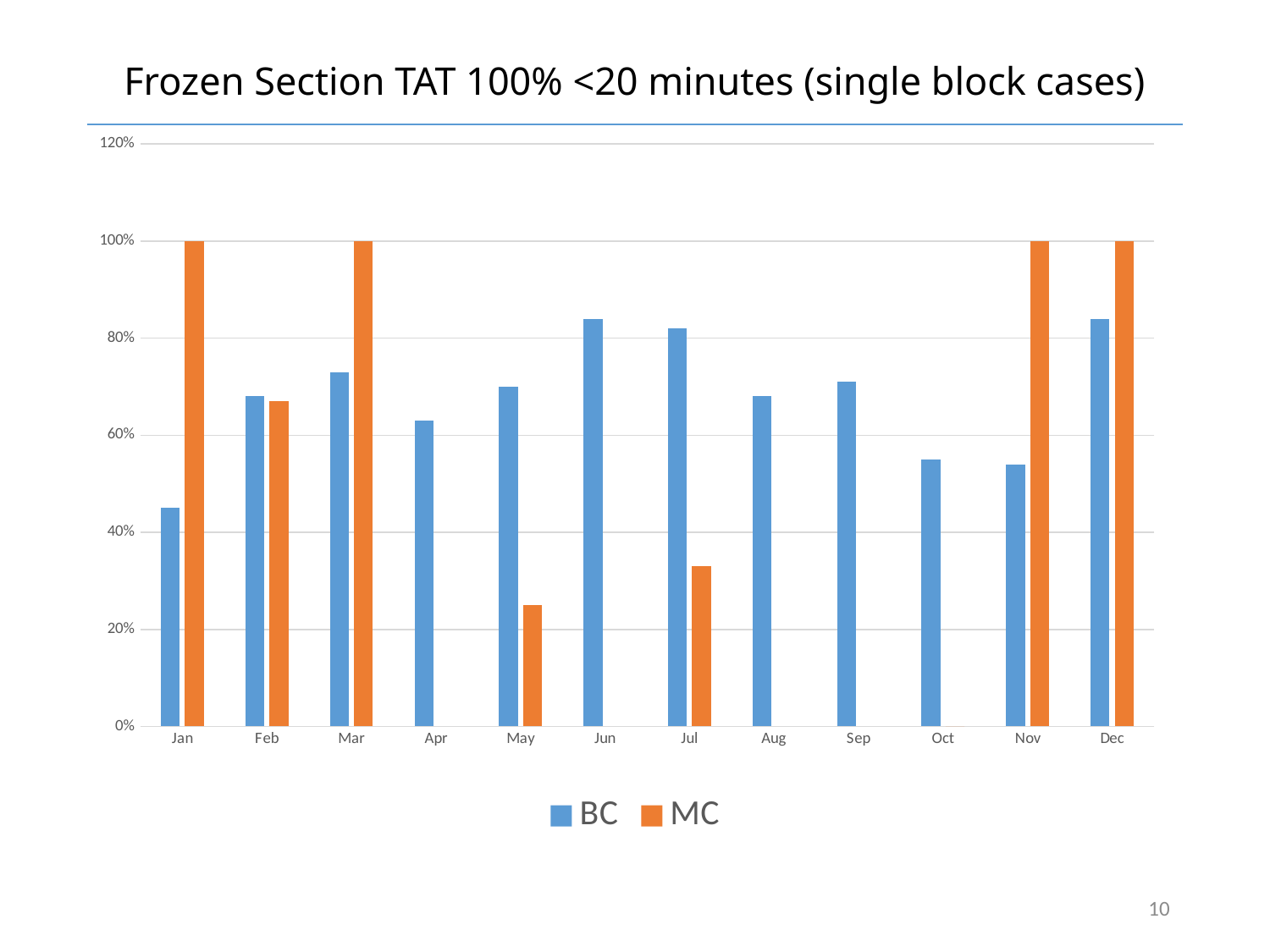
Is the value for BC in Jan greater or less than 60%? less Which month has the lowest BC value? Jan In Jan, which series has the larger value, BC or MC? MC Is the value for BC in Jun greater or less than 80%? greater How many months are shown on the x axis? 12 What is the value for MC in Jan? 100% Which month has the lowest MC value among the months where an MC bar is shown? May What is the value for MC in Nov? 100% Is the value for MC in May greater or less than 40%? less What kind of chart is shown on the slide? bar chart For BC, which is larger, Jun or Oct? Jun How many series does the legend list? 2